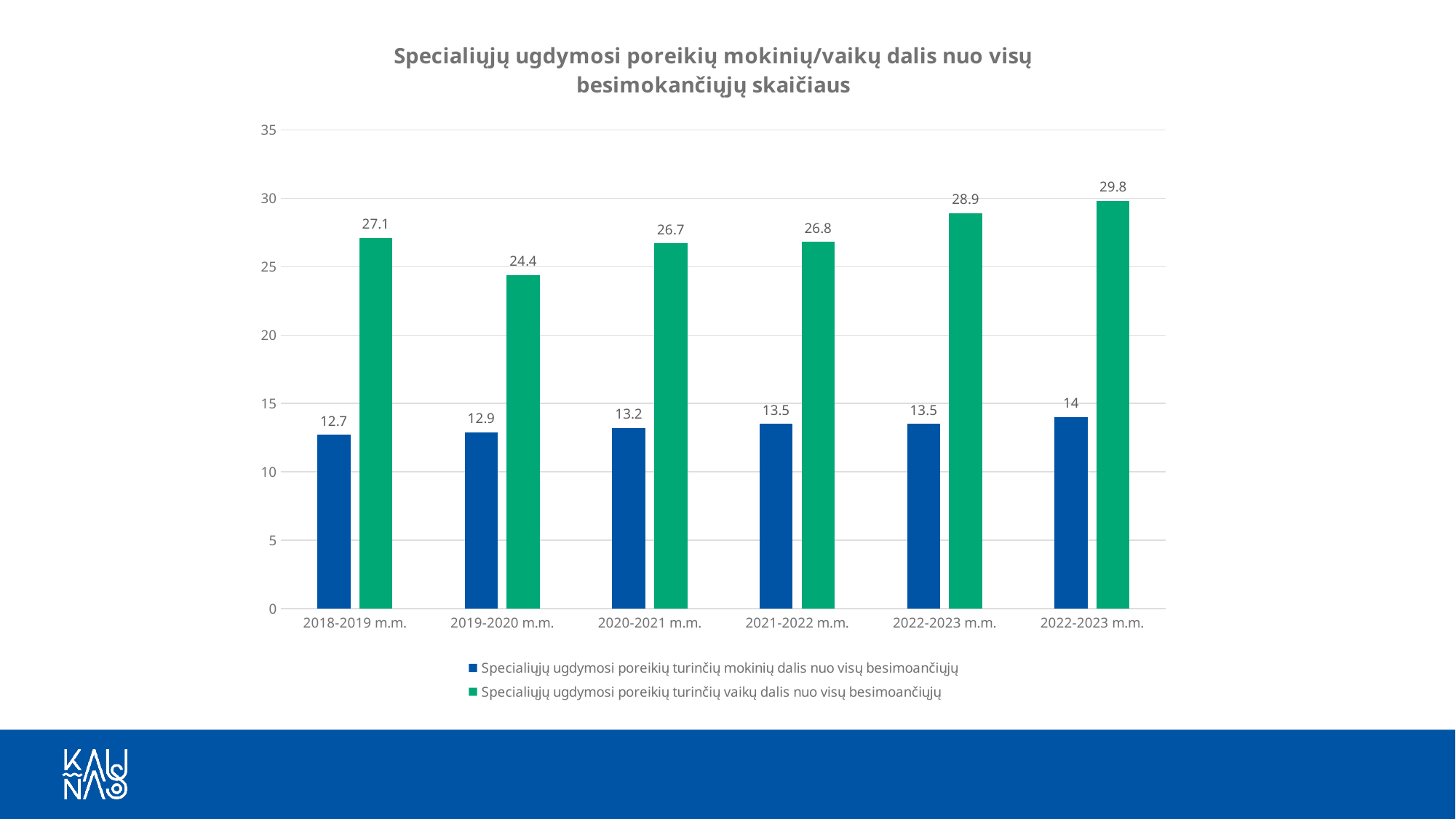
How many categories are shown on the x axis? 6 What type of chart is shown on the slide? bar chart Which is larger for 2018-2019 m.m.: the blue series (mokinių dalis) or the green series (vaikų dalis)? the green series (vaikų dalis) Does the blue series (mokinių dalis) generally rise or fall from left to right along the x axis? rise How many series does the legend list? 2 Which category has the highest value for the green series (vaikų dalis)? the last category (2022-2023 m.m.) What is the value of the blue series (mokinių dalis) for 2018-2019 m.m.? 12.7 What is the value of the green series (vaikų dalis) for 2019-2020 m.m.? 24.4 Which category has the lowest value for the green series (vaikų dalis)? 2019-2020 m.m. What is the difference between the green and blue values for 2020-2021 m.m.? 13.5 What is the value of the blue series (mokinių dalis) for the last category on the x axis? 14 What is the value of the green series (vaikų dalis) for 2021-2022 m.m.? 26.8